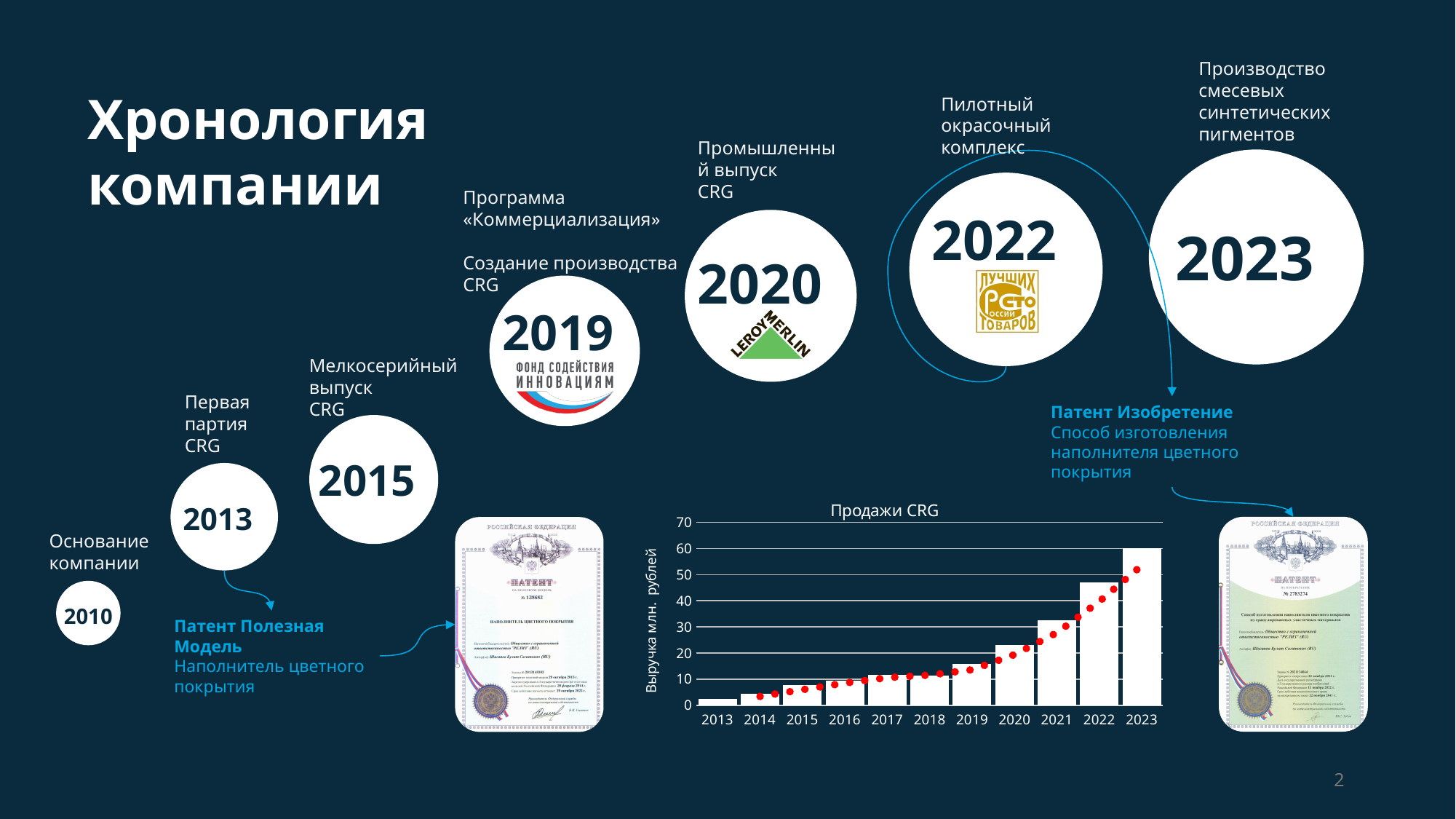
Do the values in the Продажи CRG chart rise or fall from 2013 to 2023? rise What is the label of the vertical axis in the Продажи CRG chart? Выручка млн. рублей In the Продажи CRG chart, is the value for 2019 greater or less than 20? less What type of chart is used to show Продажи CRG? bar chart In the Продажи CRG chart, which year has a larger value, 2021 or 2018? 2021 In the Продажи CRG chart, is the value for 2023 greater or less than 50? greater Which year has the lowest value in the Продажи CRG chart? 2013 How many years are shown on the x axis of the Продажи CRG chart? 11 What is the title of the chart on the slide? Продажи CRG Which year has the highest value in the Продажи CRG chart? 2023 In the Продажи CRG chart, is the value for 2020 greater or less than 20? greater